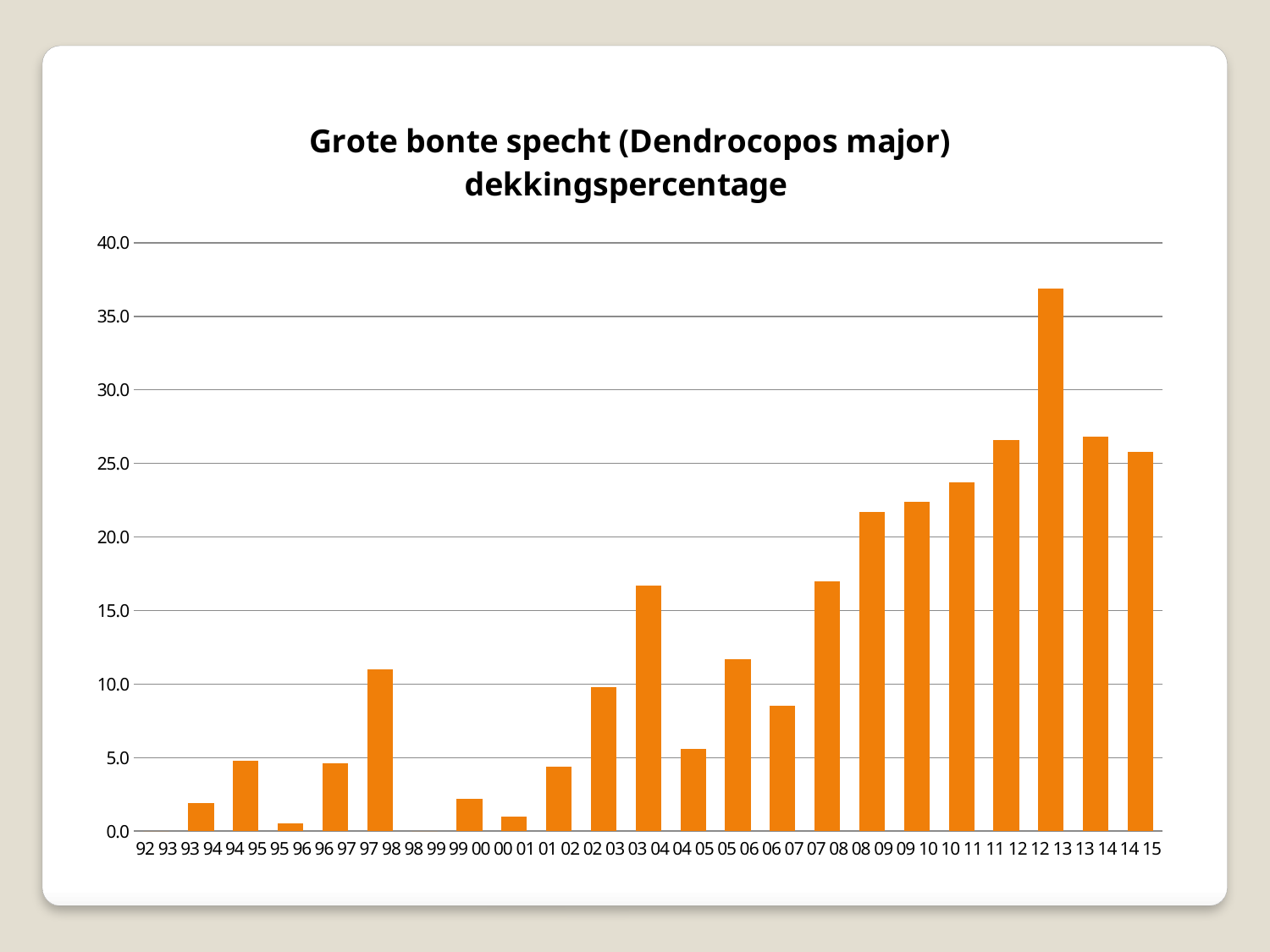
Is the value for 12 13 greater or less than 35.0? greater What is the title of the chart? Grote bonte specht (Dendrocopos major) dekkingspercentage Which is larger, the value for 12 13 or the value for 13 14? 12 13 How many categories (seasons) are shown on the x axis? 23 What kind of chart is shown on the slide? bar chart Overall, do the values rise or fall from 92 93 to 14 15? rise Is the value for 03 04 greater or less than 15.0? greater Which season has the highest dekkingspercentage? 12 13 Is the value for 08 09 greater or less than 20.0? greater Which is larger, the value for 03 04 or the value for 05 06? 03 04